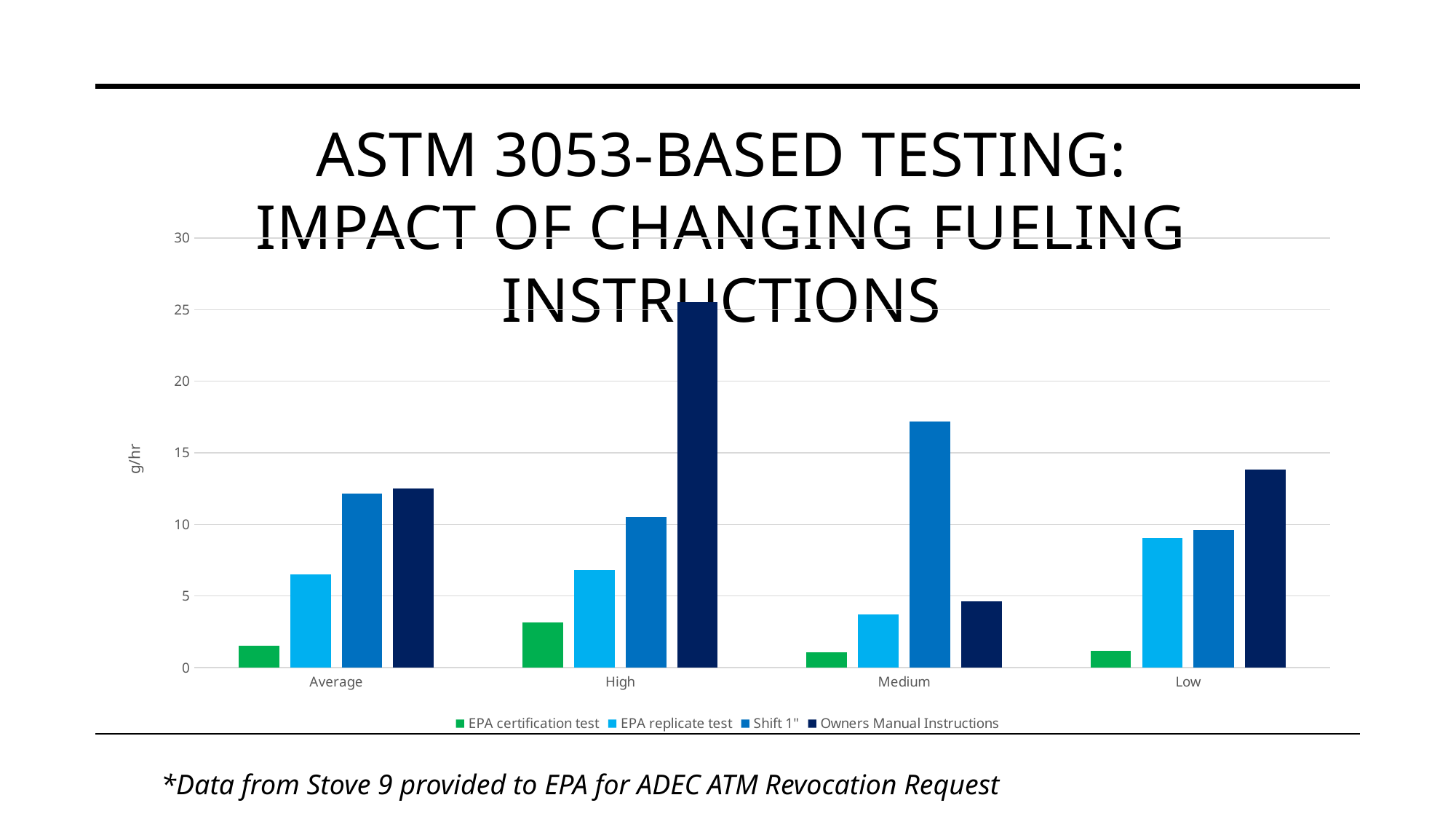
How many series does the legend list? 4 Is the Shift 1" value for Medium greater or less than 15? greater How many categories are shown on the x axis? 4 Is the Owners Manual Instructions value for High greater or less than 20? greater For the Medium category, which is larger: the Shift 1" bar or the Owners Manual Instructions bar? Shift 1" For the Average category, which is larger: the Shift 1" bar or the EPA replicate test bar? Shift 1" What kind of chart is shown on the slide? bar chart What is the label on the y axis? g/hr Is the EPA replicate test value for Low greater or less than 5? greater Which category has the highest Owners Manual Instructions bar? High Which series has the highest bar in the Low category? Owners Manual Instructions Which category has the lowest Owners Manual Instructions bar? Medium